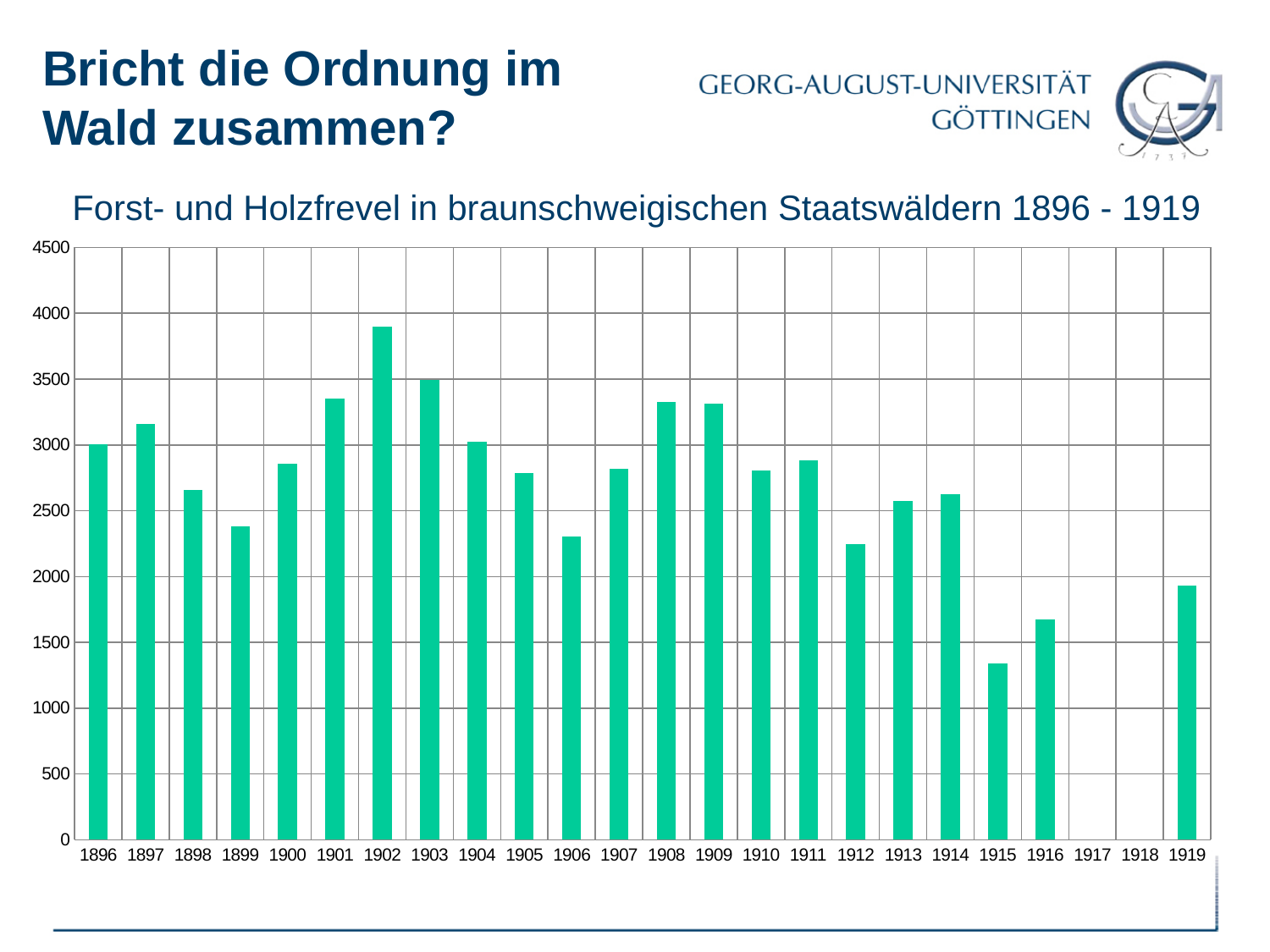
What kind of chart is shown on the slide? bar chart Which year has the highest bar in the chart? 1902 Is the value for 1915 greater or less than 1500? less Is the value for 1901 greater or less than 3000? greater Is the value for 1902 greater or less than 3500? greater Which year has the larger value, 1902 or 1903? 1902 How many years are labelled on the x axis of the chart? 24 Do the values rise or fall from 1902 to 1906? fall Which year has the larger value, 1896 or 1897? 1897 What is the title of the chart? Forst- und Holzfrevel in braunschweigischen Staatswäldern 1896 - 1919 Among the years from 1896 to 1916, which year has the lowest bar? 1915